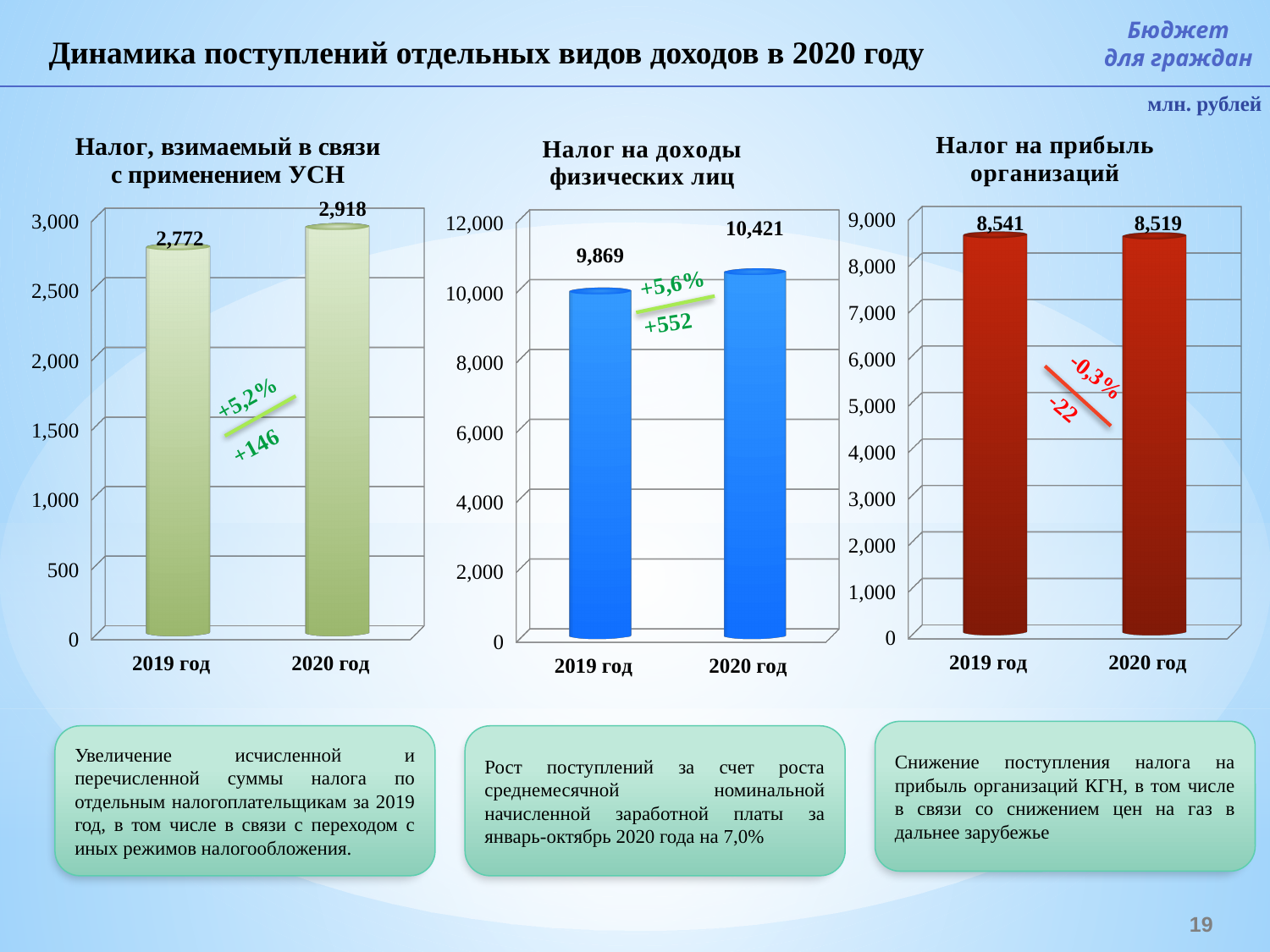
In the chart titled 'Налог, взимаемый в связи с применением УСН', what is the value for 2020 год? 2,918 How many categories are shown on the x axis of the chart titled 'Налог, взимаемый в связи с применением УСН'? 2 In the chart titled 'Налог на прибыль организаций', what is the value for 2020 год? 8,519 In the chart titled 'Налог на прибыль организаций', which year has the higher value, 2019 год or 2020 год? 2019 год In the chart titled 'Налог, взимаемый в связи с применением УСН', what is the difference between the 2020 год and 2019 год values? 146 In the chart titled 'Налог, взимаемый в связи с применением УСН', what is the value for 2019 год? 2,772 In the chart titled 'Налог на доходы физических лиц', do the values rise or fall from 2019 год to 2020 год? rise In the chart titled 'Налог на прибыль организаций', what is the value for 2019 год? 8,541 What kind of chart is the chart titled 'Налог на прибыль организаций'? bar chart In the chart titled 'Налог на доходы физических лиц', what is the value for 2020 год? 10,421 In the chart titled 'Налог на доходы физических лиц', what is the difference between the 2020 год and 2019 год values? 552 In the chart titled 'Налог на доходы физических лиц', what is the value for 2019 год? 9,869